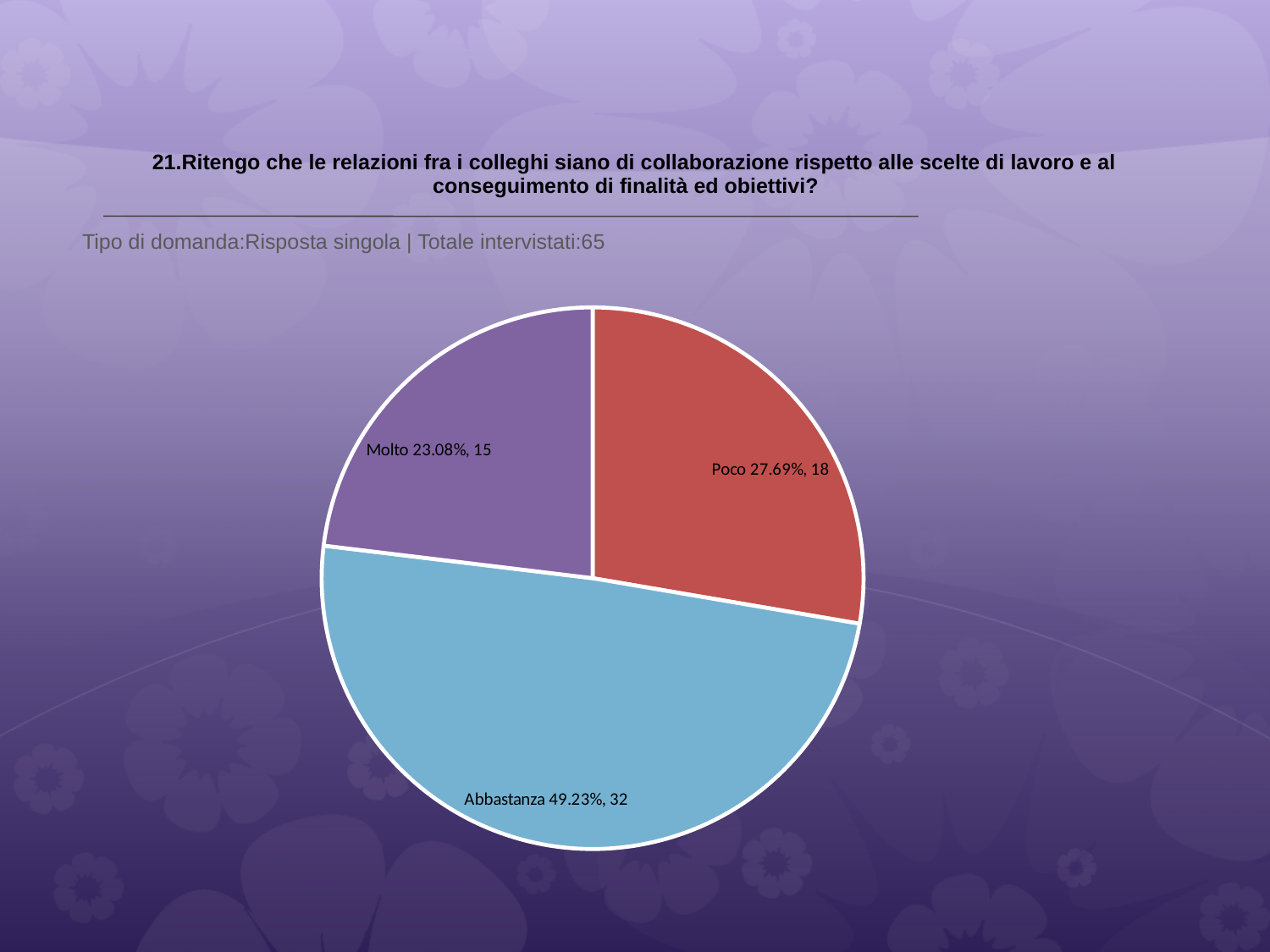
What is the difference in respondent count between Abbastanza and Poco? 14 What percentage share does the Poco slice have? 27.69% Which response has the largest slice of the pie? Abbastanza How many slices does the pie chart have? 3 Which has more respondents, Poco or Molto? Poco How many respondents answered Poco? 18 What percentage share does the Abbastanza slice have? 49.23% What colour is the Abbastanza slice? blue How many respondents answered Molto? 15 What kind of chart is shown on the slide? pie chart What is the total number of respondents across all three slices? 65 Which response has the smallest slice of the pie? Molto